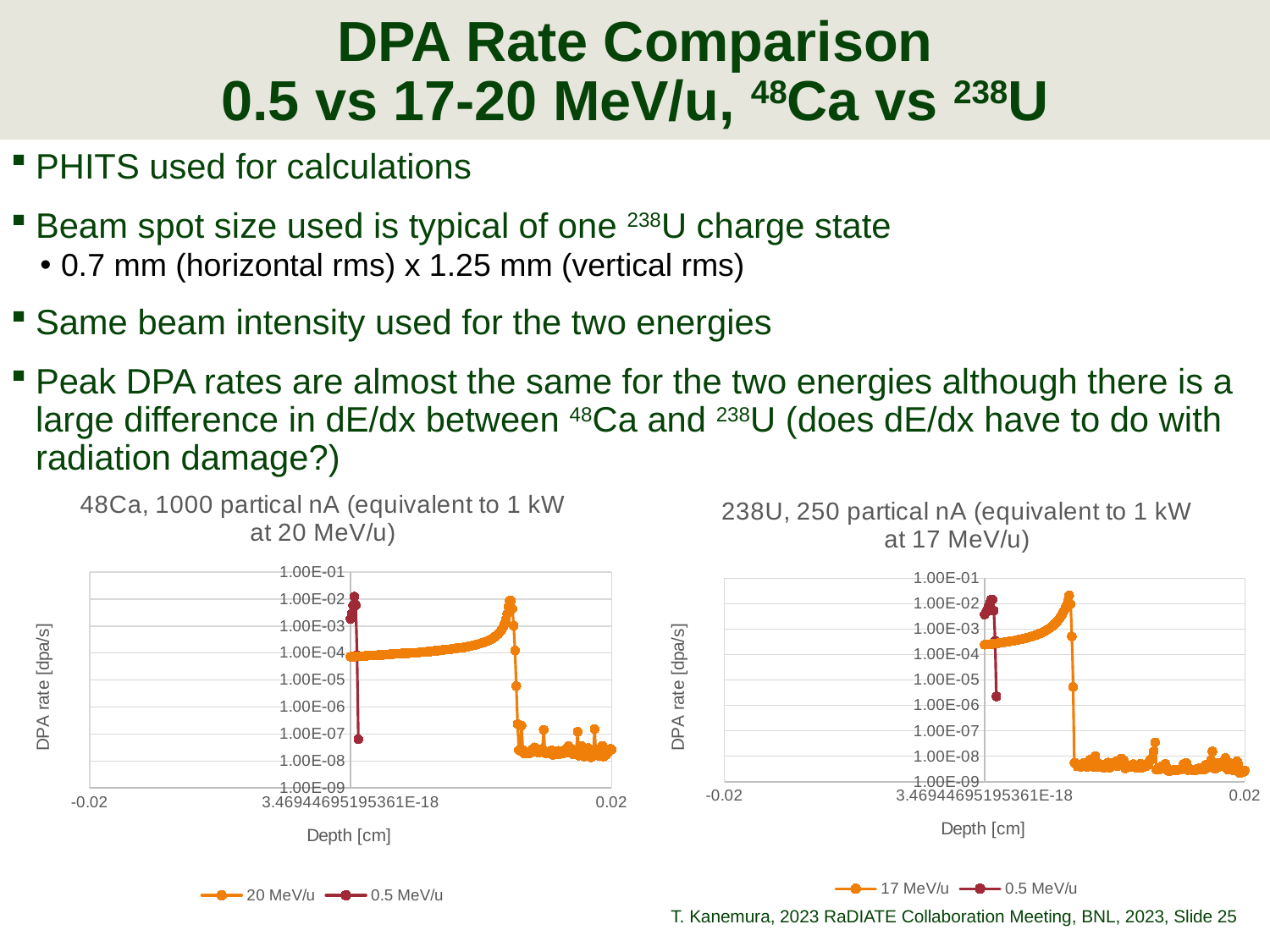
What kind of chart is the left chart (48Ca)? line chart In the left chart (48Ca), which series extends to a greater depth before dropping off, 20 MeV/u or 0.5 MeV/u? 20 MeV/u In the left chart (48Ca), how many series does the legend list? 2 What is the title of the chart on the left? 48Ca, 1000 partical nA (equivalent to 1 kW at 20 MeV/u) In the left chart (48Ca), is the peak value of the 20 MeV/u series greater or less than 1.00E-03? greater What is the title of the chart on the right? 238U, 250 partical nA (equivalent to 1 kW at 17 MeV/u) In the left chart (48Ca), is the 20 MeV/u value at a depth of 0.02 cm greater or less than 1.00E-07? less In the right chart (238U), is the 17 MeV/u value at a depth of 0.02 cm greater or less than 1.00E-07? less In the right chart (238U), how many series does the legend list? 2 In the right chart (238U), which series extends to a greater depth before dropping off, 17 MeV/u or 0.5 MeV/u? 17 MeV/u